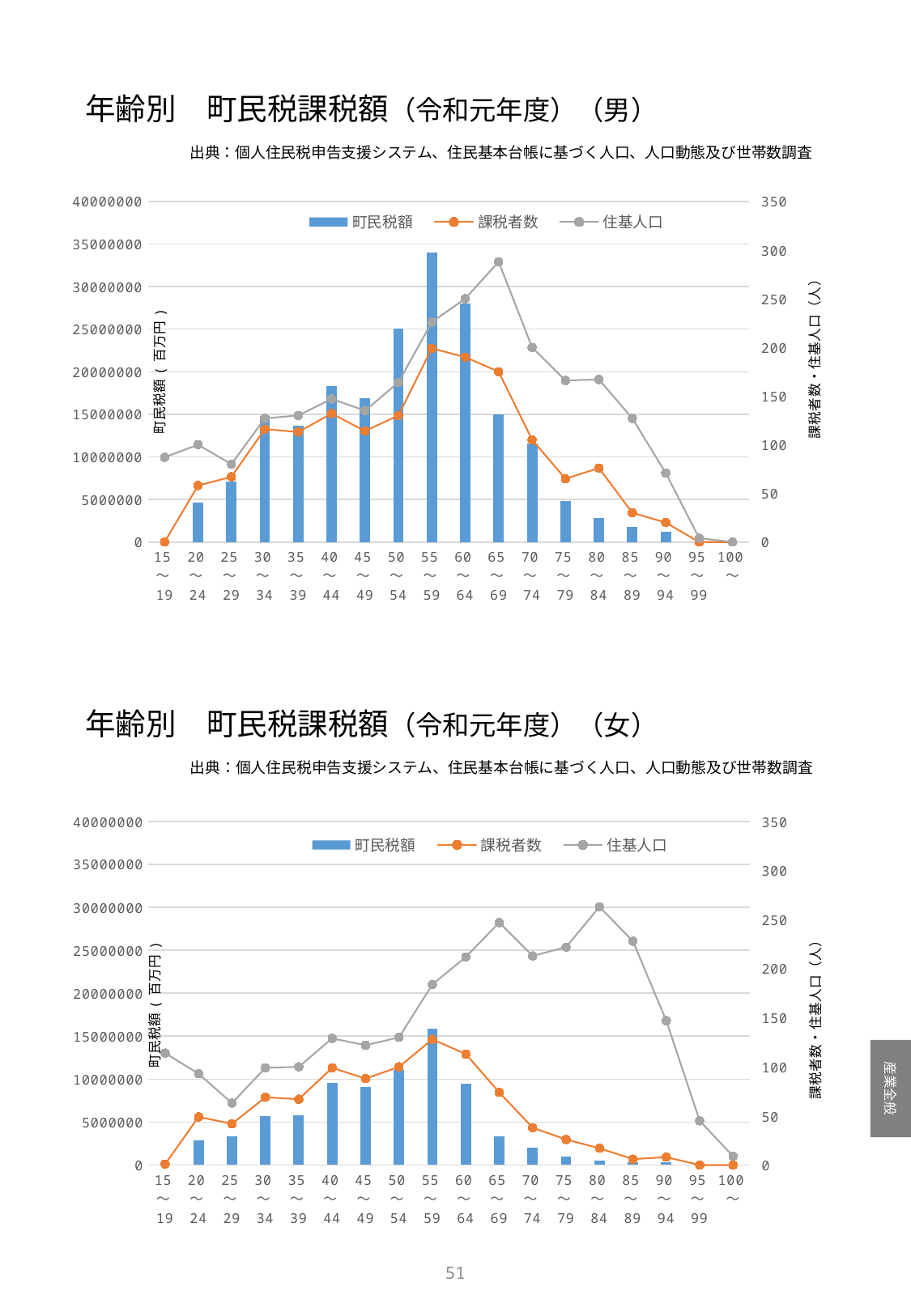
In the top chart (男), which age group has the highest 住基人口 value? 65～69 In the bottom chart (女), which age group has the highest 町民税額 bar? 55～59 In the bottom chart (女), which age group has the highest 住基人口 value? 80～84 What type of chart is the top chart (年齢別 町民税課税額（令和元年度）（男）)? Combined bar and line chart In the top chart (男), how many series does the legend list? 3 In the top chart (男), is the 住基人口 value for 65～69 greater or less than 250? greater In the top chart (男), is the 町民税額 value for 55～59 greater or less than 30000000? greater In the top chart (男), how many age categories are shown on the x axis? 18 In the top chart (男), which is larger, the 町民税額 bar for 55～59 or for 60～64? 55～59 In the bottom chart (女), is the 町民税額 value for 55～59 greater or less than 10000000? greater In the bottom chart (女), which is larger, the 町民税額 bar for 40～44 or for 65～69? 40～44